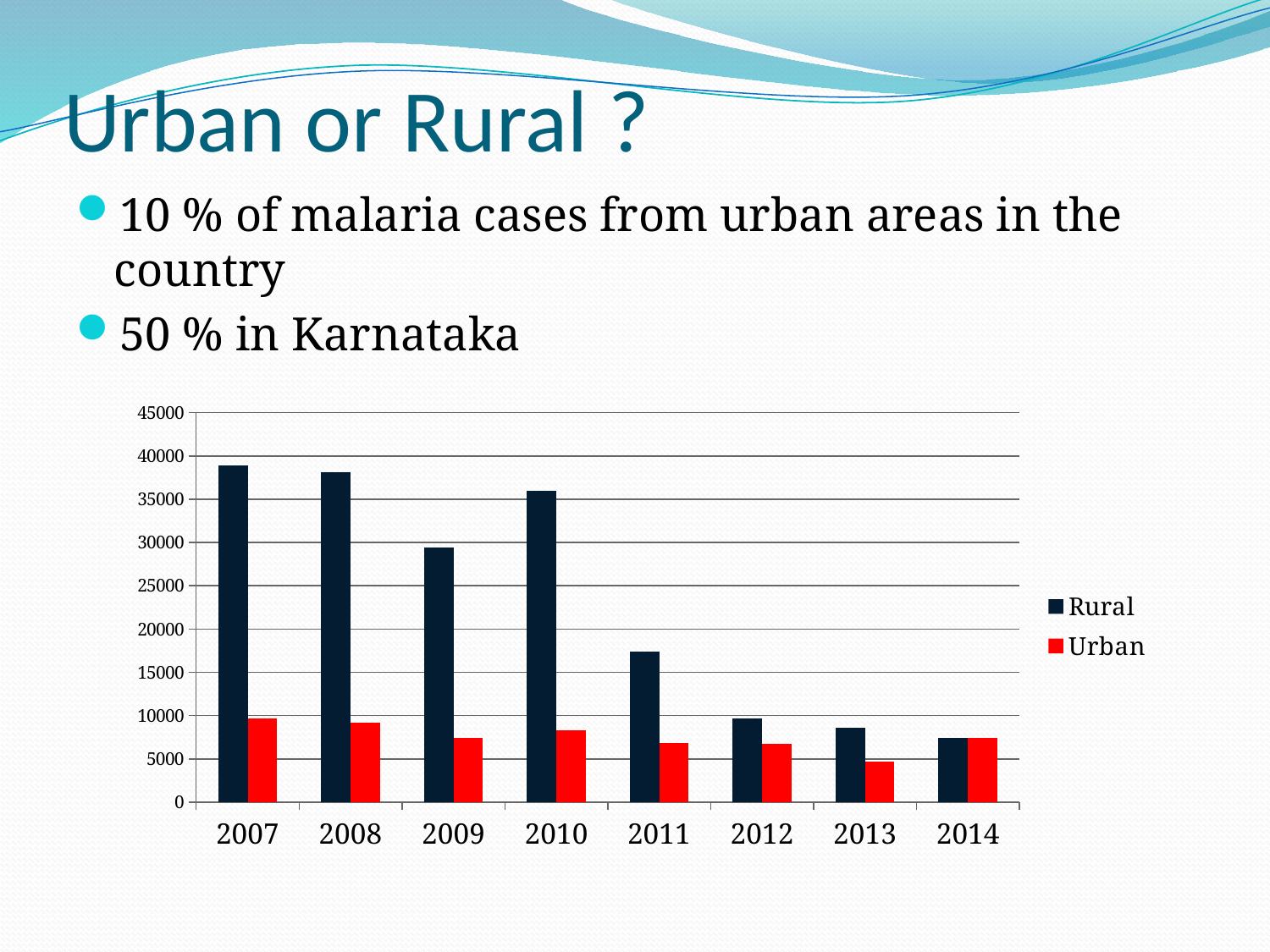
What kind of chart is shown on the slide? bar chart Overall, do the Rural values rise or fall from 2007 to 2014? fall Which colour represents the Urban series in the chart? red How many series does the chart legend list? 2 Is the Rural value for 2011 greater or less than 15000? greater Is the Rural value for 2007 greater or less than 35000? greater How many years are shown on the x axis of the chart? 8 Which year has the lowest Urban value? 2013 Which is larger, the Rural value for 2009 or the Rural value for 2010? 2010 Which year has the lowest Rural value? 2014